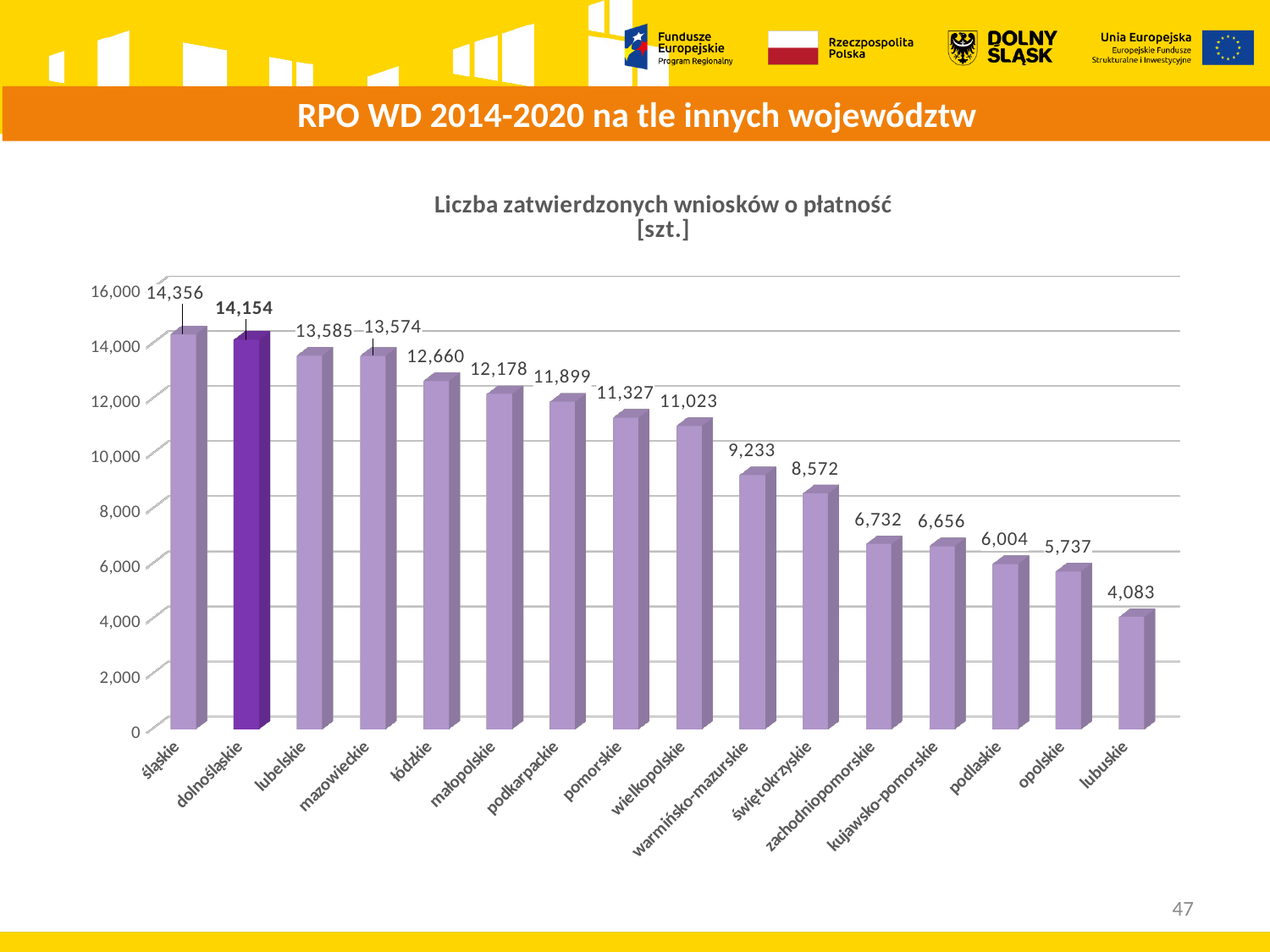
Which voivodeship has the highest number of approved payment applications? śląskie Which voivodeship has the lowest number of approved payment applications? lubuskie How many voivodeships are shown on the chart? 16 What is the value for warmińsko-mazurskie? 9,233 What is the value for dolnośląskie? 14,154 Which is larger, the value for pomorskie or the value for wielkopolskie? pomorskie Which bar is highlighted in a darker purple colour? dolnośląskie Do the values rise or fall from left to right along the x axis? fall What is the value for lubuskie? 4,083 Is the value for świętokrzyskie greater or less than 10,000? less What kind of chart is shown on the slide? bar chart What is the difference between the values for śląskie and dolnośląskie? 202